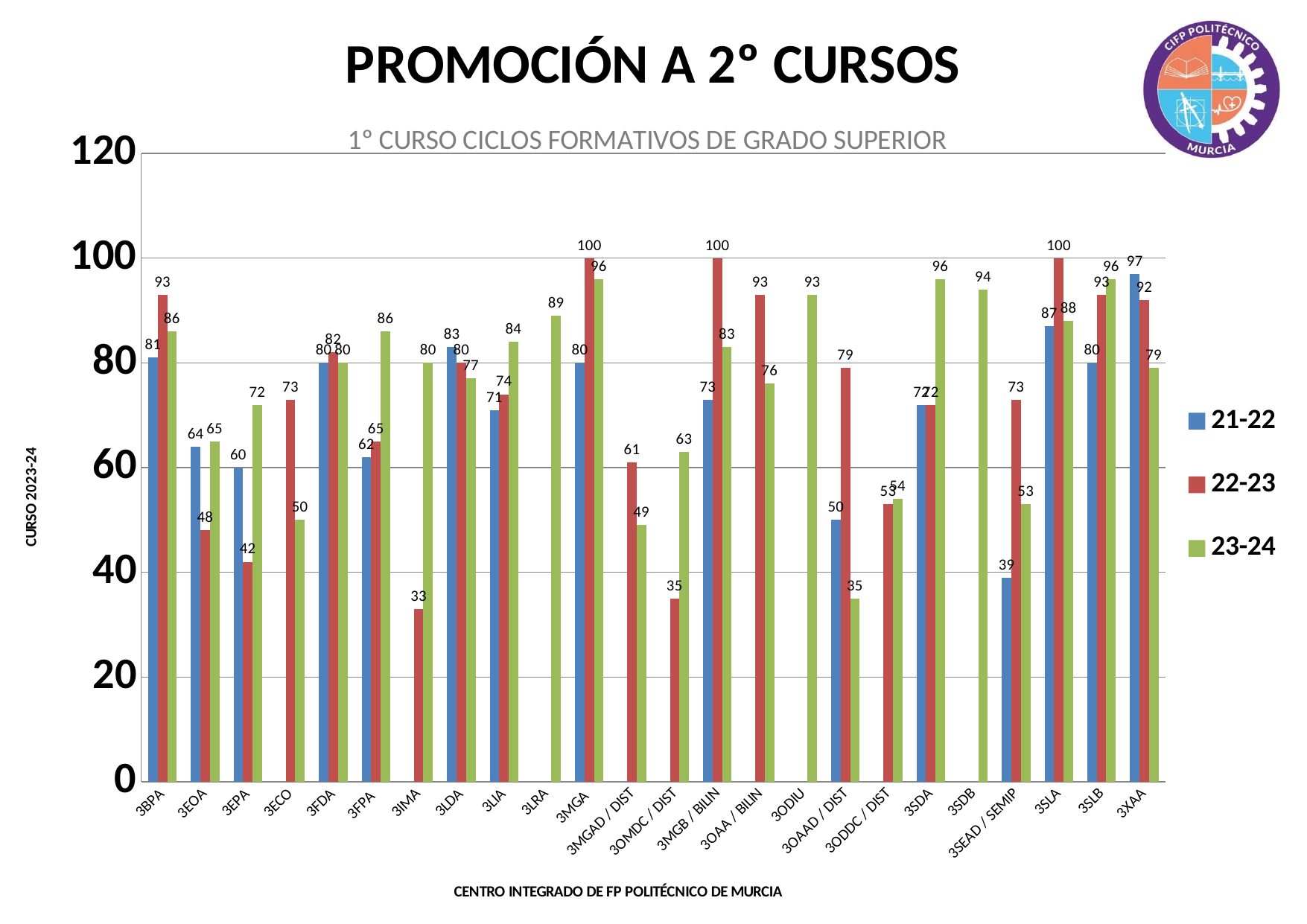
What is the difference between the 23-24 and 22-23 values for 3EPA? 30 For 3XAA, which series has the larger value, 21-22 or 23-24? 21-22 What is the value for 3IMA in the 23-24 series? 80 Which category has the highest value in the 21-22 series? 3XAA What is the value for 3BPA in the 22-23 series? 93 What is the value for 3OAAD / DIST in the 21-22 series? 50 Is the value for 3SEAD / SEMIP in the 21-22 series greater or less than 40? less Which category has the lowest value in the 23-24 series? 3OAAD / DIST What kind of chart is shown on the slide? bar chart Which category has the lowest value in the 22-23 series? 3IMA How many series does the legend list? 3 How many categories are shown on the x axis? 24